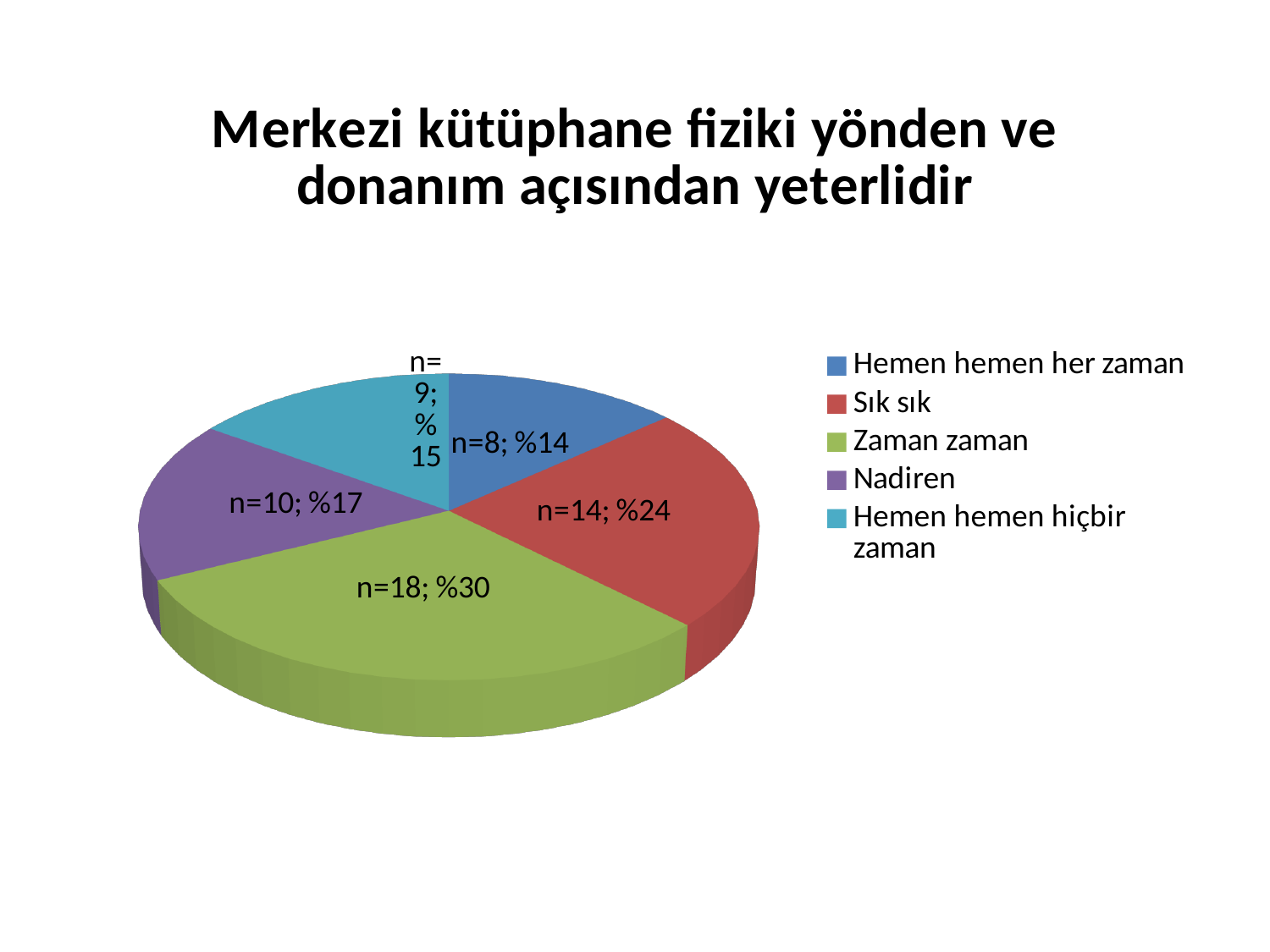
What is the n value for the 'Hemen hemen her zaman' slice? n=8 How many entries does the legend list? 5 Which is larger, the 'Nadiren' slice or the 'Hemen hemen her zaman' slice? Nadiren What is the n value for the 'Zaman zaman' slice? n=18 How many slices does the pie chart have? 5 What percentage share does the 'Nadiren' slice have? %17 What percentage share does the 'Sık sık' slice have? %24 What is the difference in n between 'Zaman zaman' and 'Sık sık'? 4 Which category has the largest slice? Zaman zaman Which category has the smallest slice? Hemen hemen her zaman What kind of chart is shown on the slide? pie chart What is the n value for the 'Hemen hemen hiçbir zaman' slice? n=9